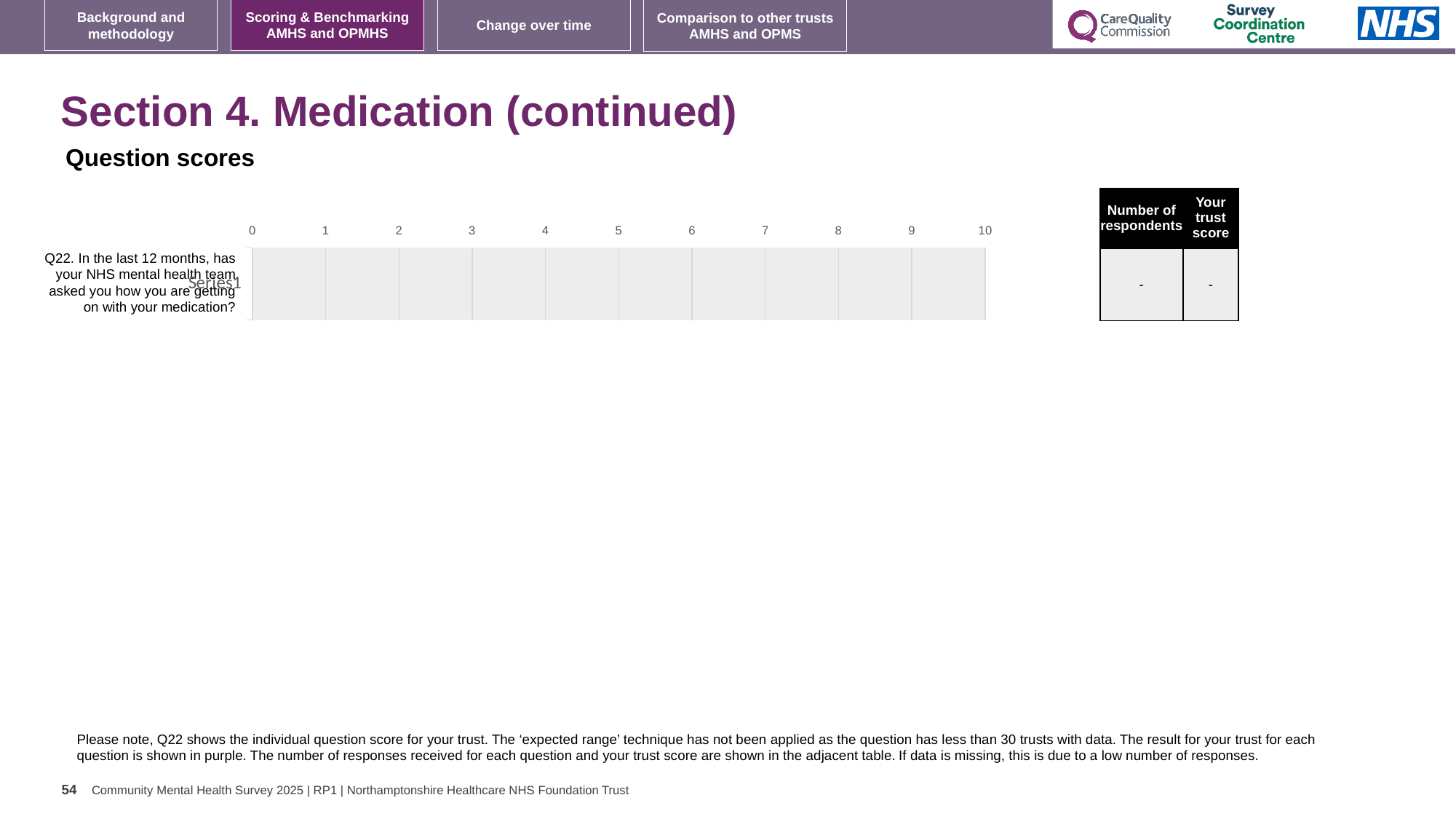
What is shown in the 'Your trust score' column of the table for Q22? - How many question categories are listed on the chart's vertical axis? 1 What is the lowest value shown on the chart's horizontal axis? 0 Is a bar plotted for Q22 on the chart? No What kind of chart is shown on the slide? bar chart What is shown in the 'Number of respondents' column of the table for Q22? - What is the highest value shown on the chart's horizontal axis? 10